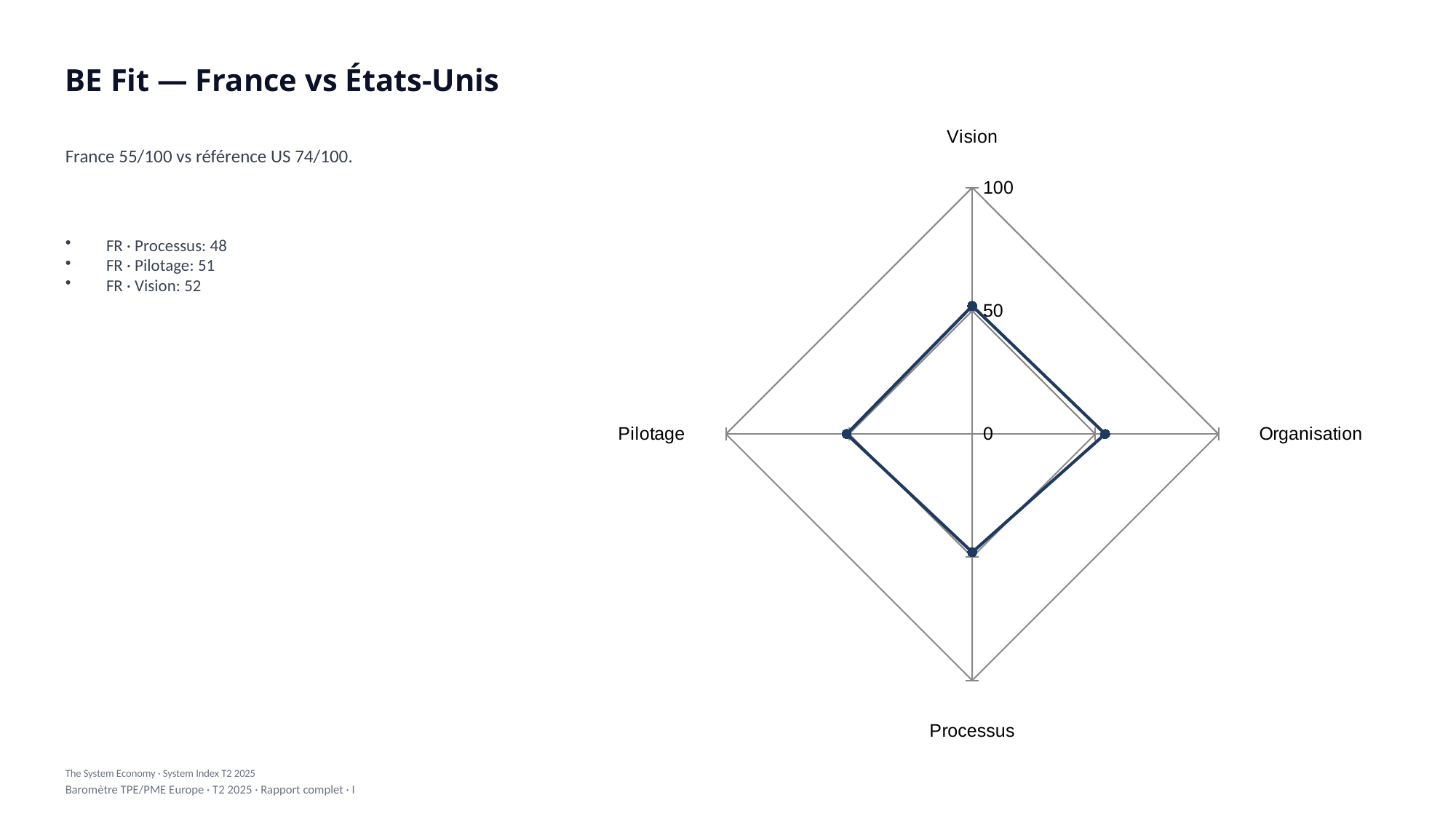
According to the slide, what is the FR value for Processus? 48 Is the value for Organisation on the radar chart greater or less than 100? less What is the difference between the FR values for Vision and Processus listed on the slide? 4 What kind of chart is shown on the slide? radar chart Is the value for Vision on the radar chart greater or less than 100? less How many axes (categories) does the radar chart have? 4 What is the maximum value shown on the radar chart's scale? 100 Among the FR values listed on the slide (Processus, Pilotage, Vision), which is the lowest? Processus According to the slide, what is the FR value for Vision? 52 What are the four category labels on the radar chart? Vision, Organisation, Processus, Pilotage According to the slide, what is the FR value for Pilotage? 51 Is the value for Processus on the radar chart greater or less than 0? greater